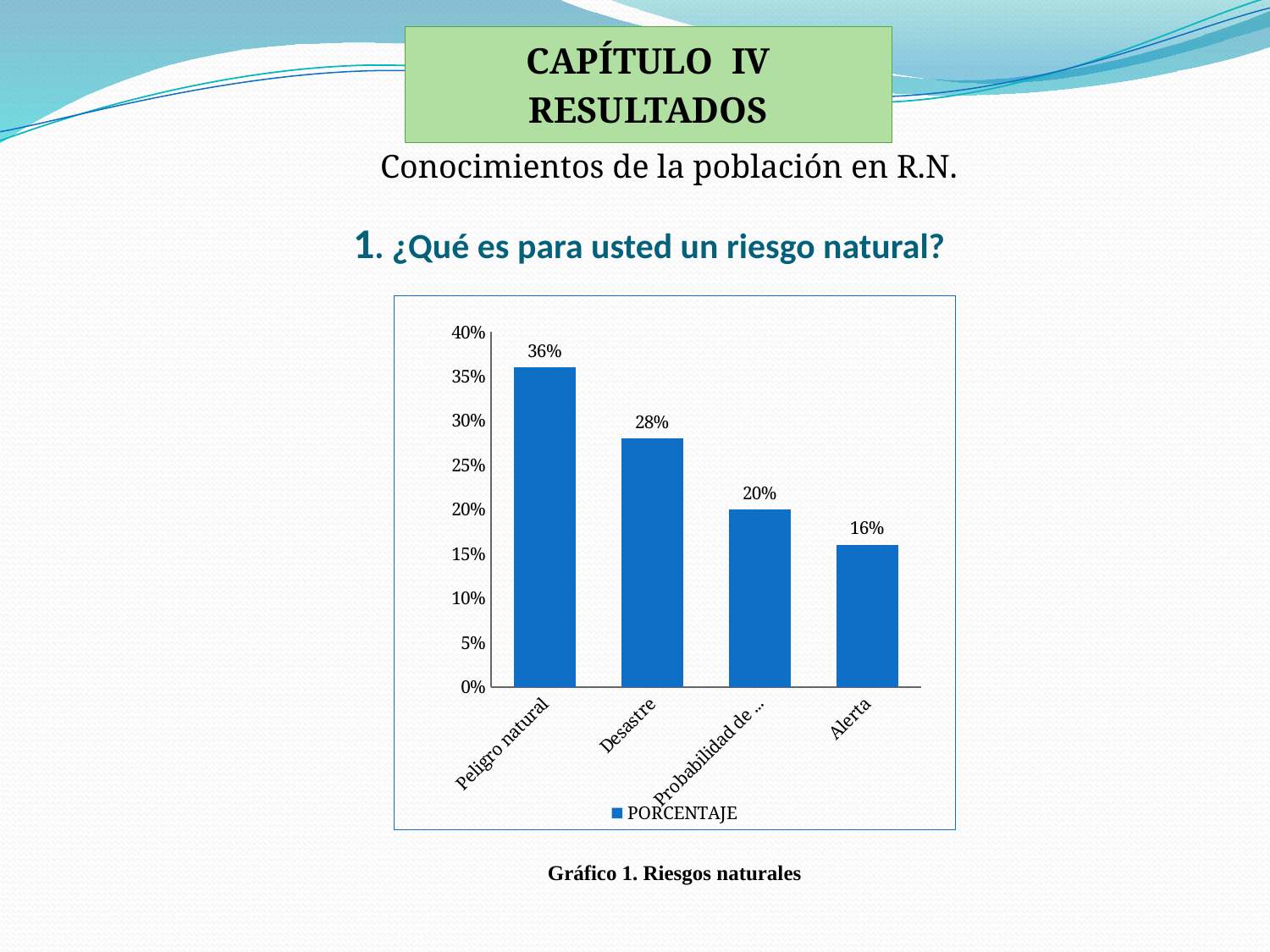
Which is larger, the value for Desastre or the value for Alerta? Desastre Do the values rise or fall from left to right along the x axis? Fall What is the value for Peligro natural? 36% Which category has the lowest value? Alerta Which category has the highest value? Peligro natural What is the value for Desastre? 28% What is the difference between the values for Peligro natural and Desastre? 8% What is the value for Alerta? 16% How many series does the legend list? 1 What is the difference between the values for Desastre and Alerta? 12% What kind of chart is shown? Bar chart How many categories are shown on the x axis? 4